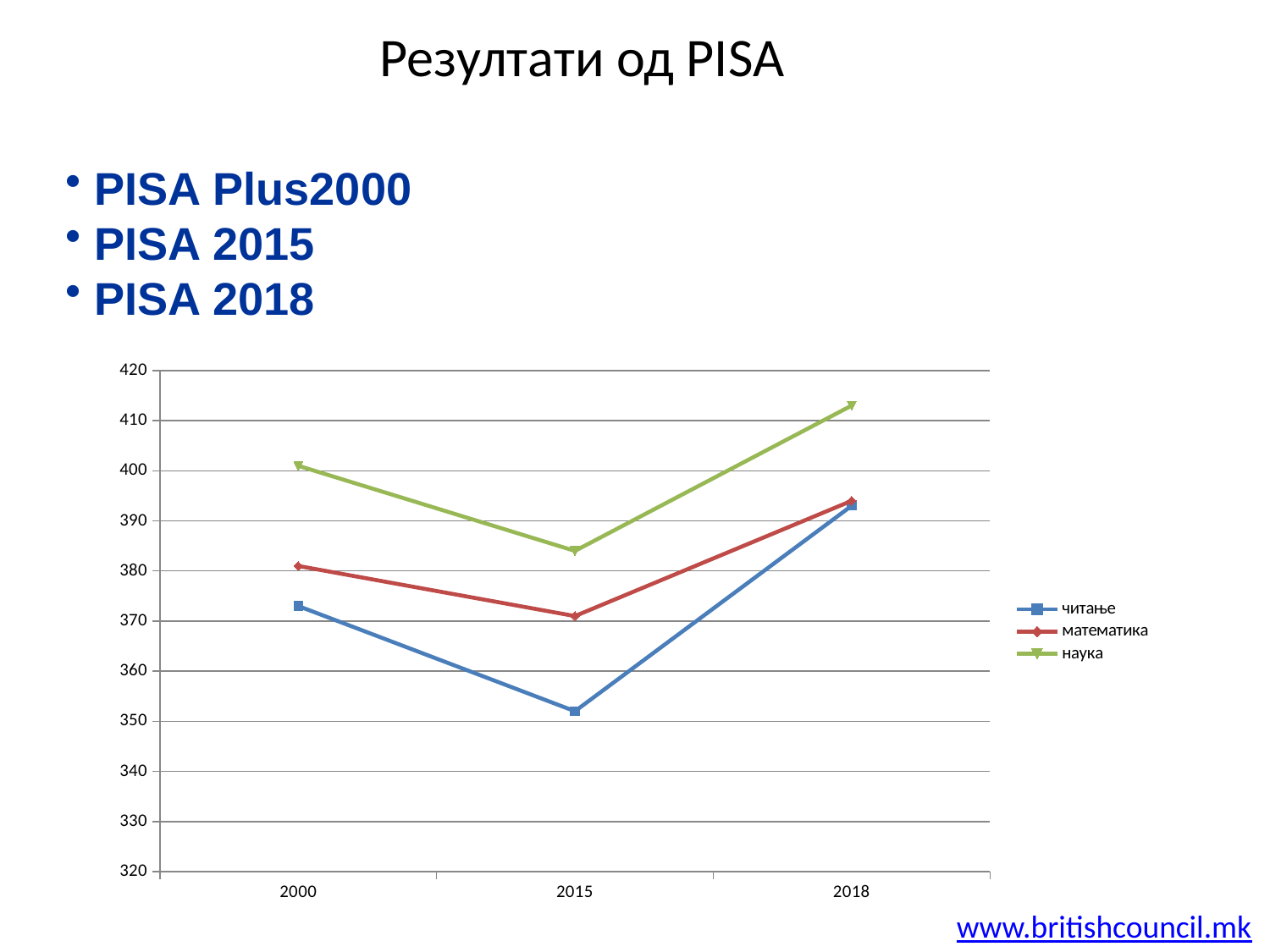
Which series has the highest value in 2018? наука How many years are shown on the x axis of the chart? 3 How many series does the chart legend list? 3 Is the value for наука in 2018 greater or less than 410? greater Which series is drawn in green on the chart? наука Which series has the lowest value in 2015? читање Does the value for читање rise or fall from 2015 to 2018? rise Which is larger: the value for наука in 2015 or the value for математика in 2015? наука Is the value for математика in 2000 greater or less than 390? less What kind of chart is shown on the slide? line chart Is the value for читање in 2015 greater or less than 360? less